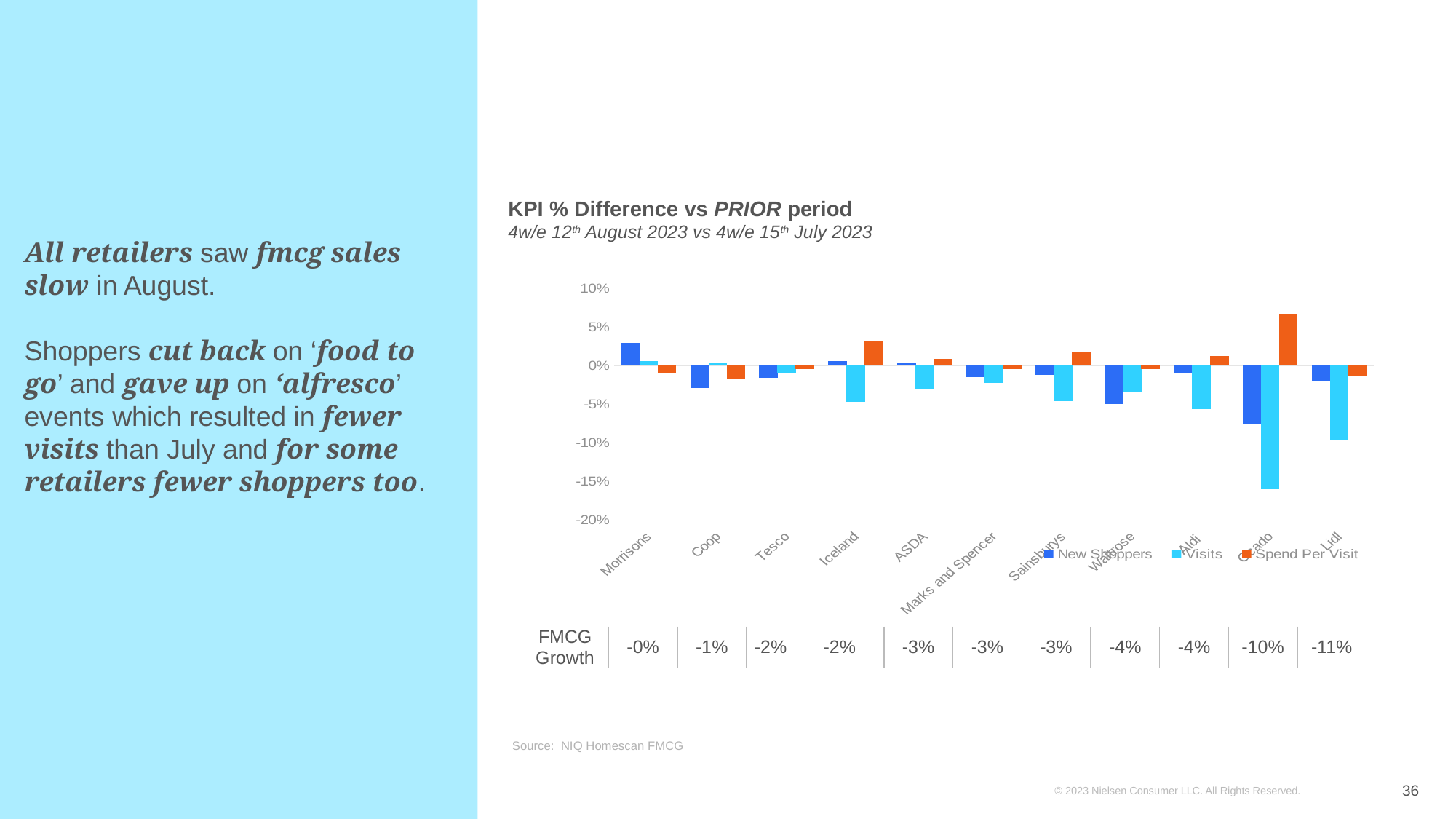
Which is lower, the Visits value for Ocado or the Visits value for Lidl? Ocado Is the New Shoppers value for Ocado greater or less than -5%? less What FMCG Growth value is shown beneath Lidl? -11% Which retailer has the lowest Visits value in the chart? Ocado Is the Spend Per Visit value for Ocado greater or less than 5%? greater How many retailers are shown on the x axis of the chart? 11 What FMCG Growth value is shown beneath Ocado? -10% Which retailer has the highest Spend Per Visit value in the chart? Ocado What kind of chart is shown on the slide? bar chart How many series does the chart legend list? 3 Is the Visits value for Ocado greater or less than -15%? less What is the title of the chart? KPI % Difference vs PRIOR period